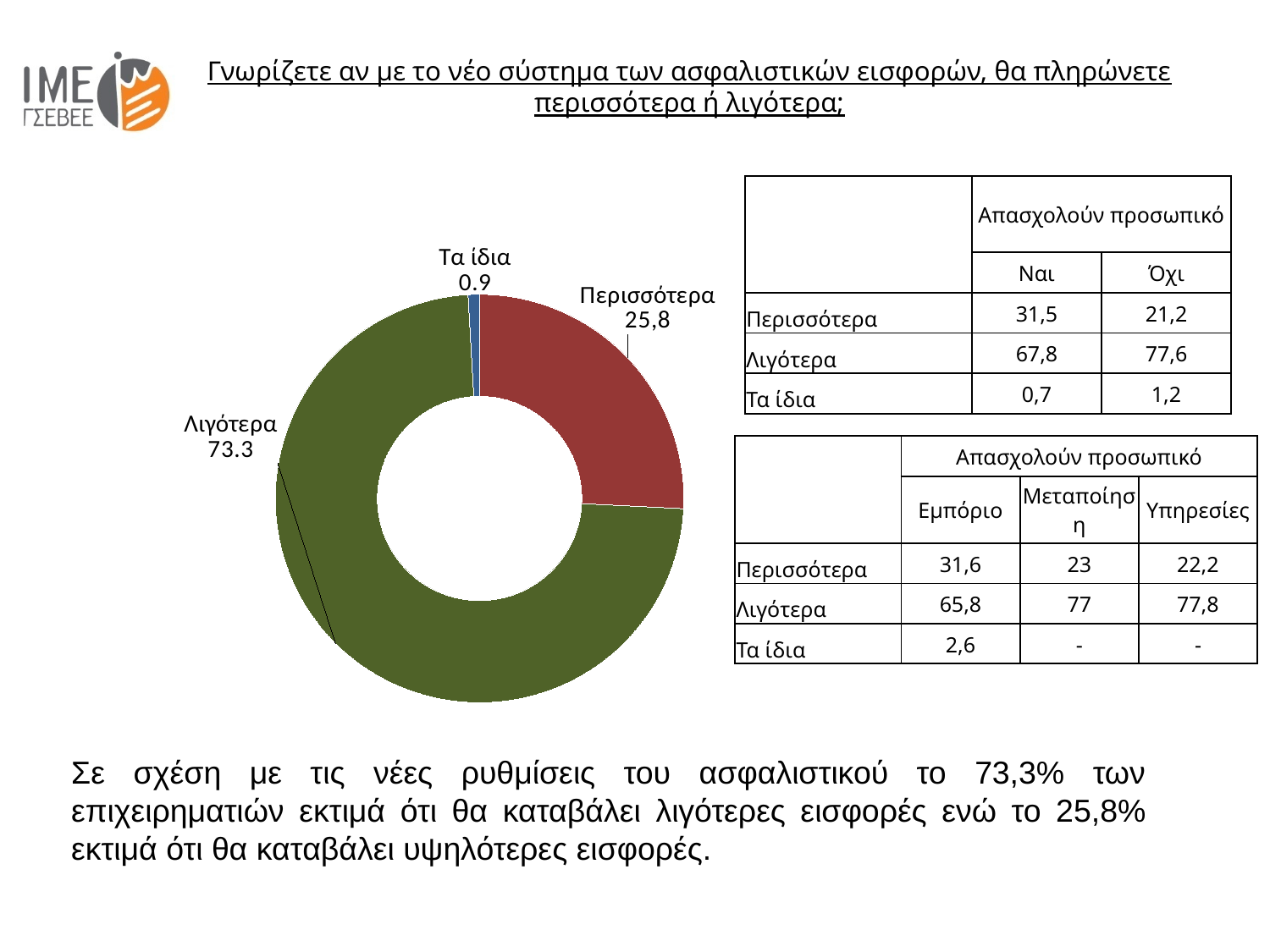
Which category has the largest slice in the doughnut chart? Λιγότερα What colour is the Λιγότερα slice in the doughnut chart? Green What is the total of the three values shown on the doughnut chart? 100 In the doughnut chart, which is larger: Περισσότερα or Τα ίδια? Περισσότερα What is the value shown for the Περισσότερα slice of the doughnut chart? 25,8 What is the value shown for the Λιγότερα slice of the doughnut chart? 73.3 Which category has the smallest slice in the doughnut chart? Τα ίδια What type of chart is shown on the left of the slide? Doughnut (pie) chart What is the difference between the Λιγότερα and Περισσότερα values in the doughnut chart? 47.5 What colour is the Περισσότερα slice in the doughnut chart? Red What is the value shown for the Τα ίδια slice of the doughnut chart? 0.9 How many categories (slices) does the doughnut chart show? 3